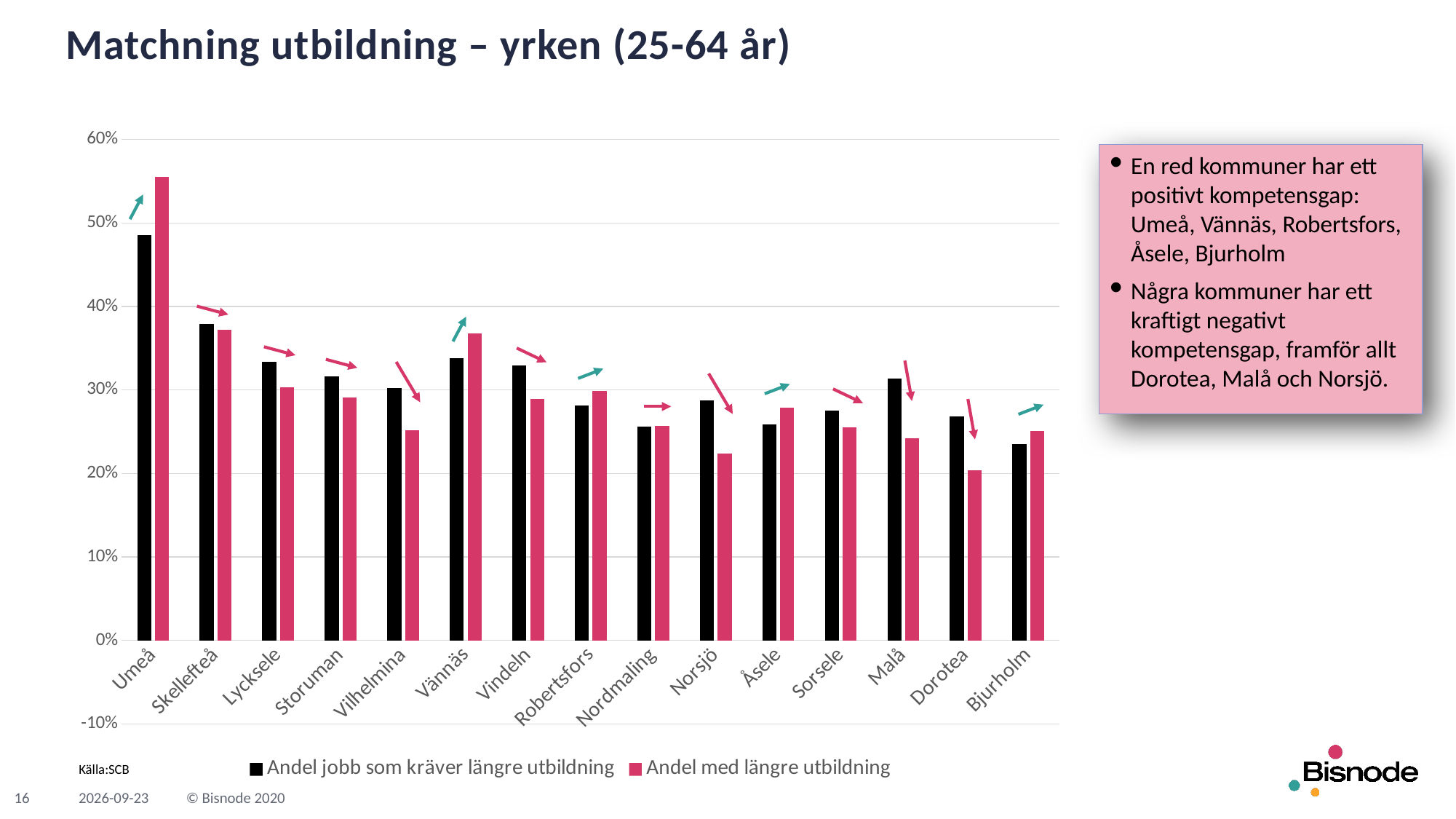
Is the value of 'Andel jobb som kräver längre utbildning' for Umeå greater or less than 50%? less Which municipality has the lowest value for 'Andel med längre utbildning'? Dorotea Which municipality has the highest value for 'Andel med längre utbildning'? Umeå How many series does the chart legend list? 2 For Norsjö, which is larger: 'Andel jobb som kräver längre utbildning' or 'Andel med längre utbildning'? Andel jobb som kräver längre utbildning For Vännäs, which is larger: 'Andel jobb som kräver längre utbildning' or 'Andel med längre utbildning'? Andel med längre utbildning Is the value of 'Andel med längre utbildning' for Norsjö greater or less than 30%? less How many municipalities (categories) are shown on the x axis of the chart? 15 What kind of chart is shown on the slide? bar chart Is the value of 'Andel med längre utbildning' for Umeå greater or less than 50%? greater Which municipality has the highest value for 'Andel jobb som kräver längre utbildning'? Umeå